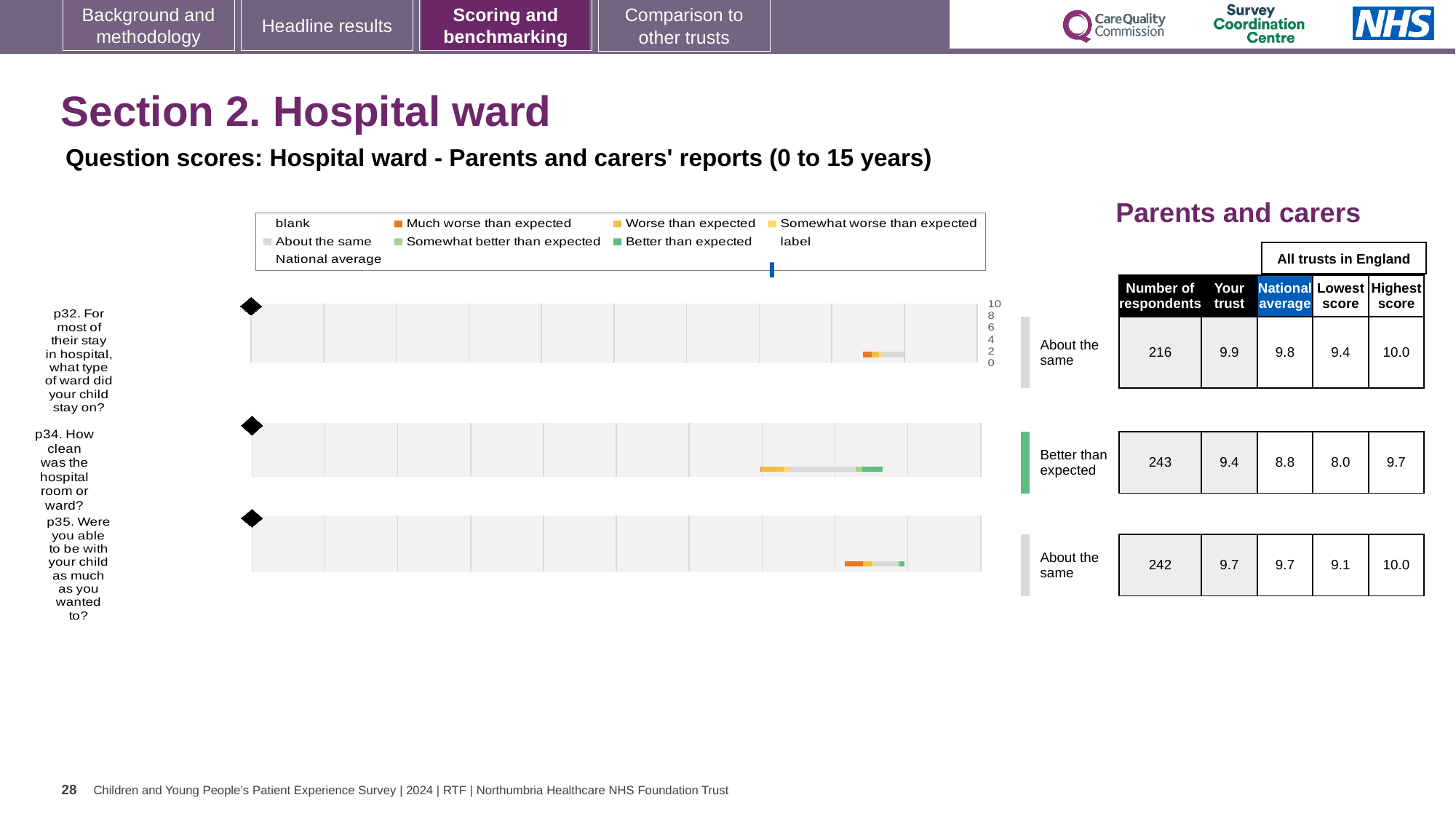
How many questions are plotted in the chart? 3 Which question has the lowest 'Your trust' score? p34 What is the highest score across all trusts in England for p34? 9.7 For p32, which is larger: the 'Your trust' score or the national average? Your trust What is the lowest score across all trusts in England for p35? 9.1 What kind of chart is used to show the question scores on this slide? bar chart What is the 'Your trust' score for p32 (what type of ward did your child stay on)? 9.9 How many respondents answered p35 (were you able to be with your child as much as you wanted to)? 242 What is the national average score for p34 (how clean was the hospital room or ward)? 8.8 Which question has the highest 'Your trust' score? p32 Which question is rated 'Better than expected' in the chart? p34. How clean was the hospital room or ward? What is the difference between the 'Your trust' score and the national average for p34? 0.6